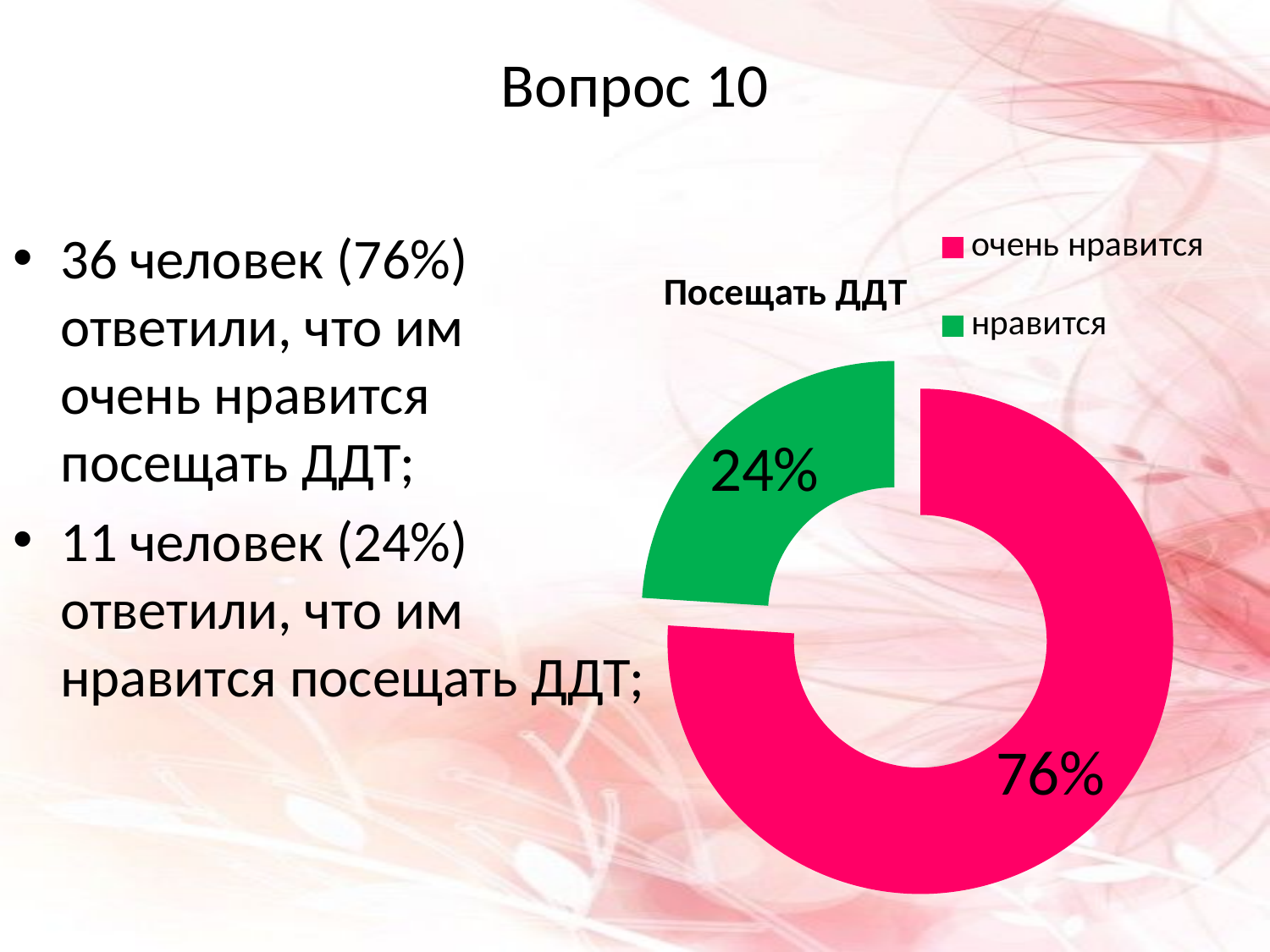
Which slice is larger, 'очень нравится' or 'нравится'? очень нравится What share of the chart does the 'очень нравится' slice represent? 76% How many entries does the legend list? 2 What share of the chart does the 'нравится' slice represent? 24% What kind of chart is shown on the slide? Pie chart (doughnut) What is the total of the two slices shown in the chart? 100% How many categories are shown in the chart? 2 Which category has the smallest slice in the chart? нравится What colour is the 'нравится' slice? Green What is the difference in percentage points between the 'очень нравится' and 'нравится' slices? 52 Which category has the largest slice in the chart? очень нравится What is the title of the chart? Посещать ДДТ